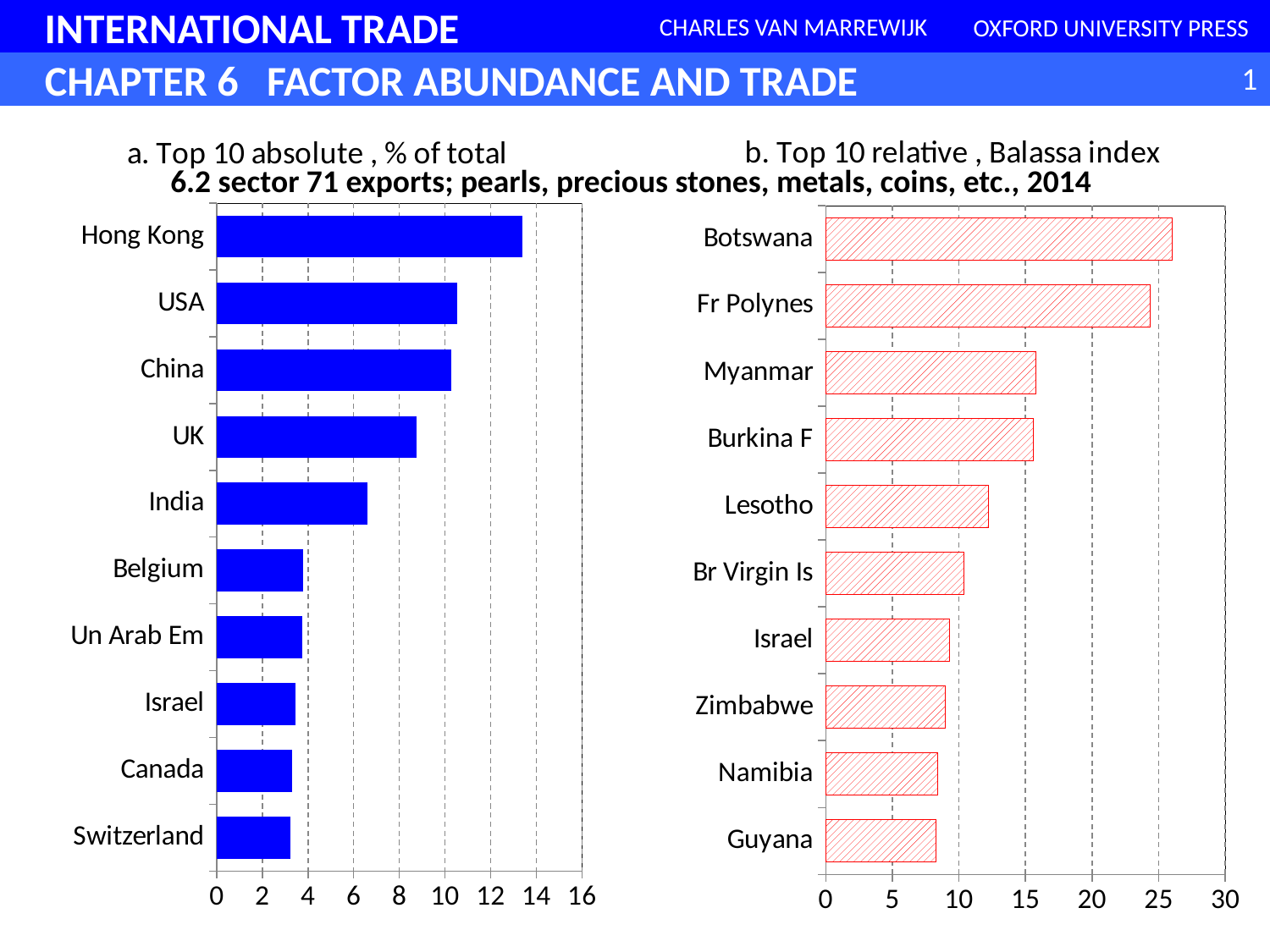
In the right chart 'b. Top 10 relative, Balassa index', is the value for Guyana greater or less than 10? less How many countries are shown in the right chart 'b. Top 10 relative, Balassa index'? 10 In the left chart 'a. Top 10 absolute, % of total', which has the larger value, USA or UK? USA In the left chart 'a. Top 10 absolute, % of total', which country has the highest value? Hong Kong In the left chart 'a. Top 10 absolute, % of total', is the value for Hong Kong greater or less than 12? greater How many countries are shown in the left chart 'a. Top 10 absolute, % of total'? 10 In the right chart 'b. Top 10 relative, Balassa index', which has the larger value, Fr Polynes or Myanmar? Fr Polynes What is the overall title shown above the two charts? 6.2 sector 71 exports; pearls, precious stones, metals, coins, etc., 2014 What kind of chart is the left chart, 'a. Top 10 absolute, % of total'? bar chart In the right chart 'b. Top 10 relative, Balassa index', which country has the highest value? Botswana In the right chart 'b. Top 10 relative, Balassa index', is the value for Botswana greater or less than 25? greater